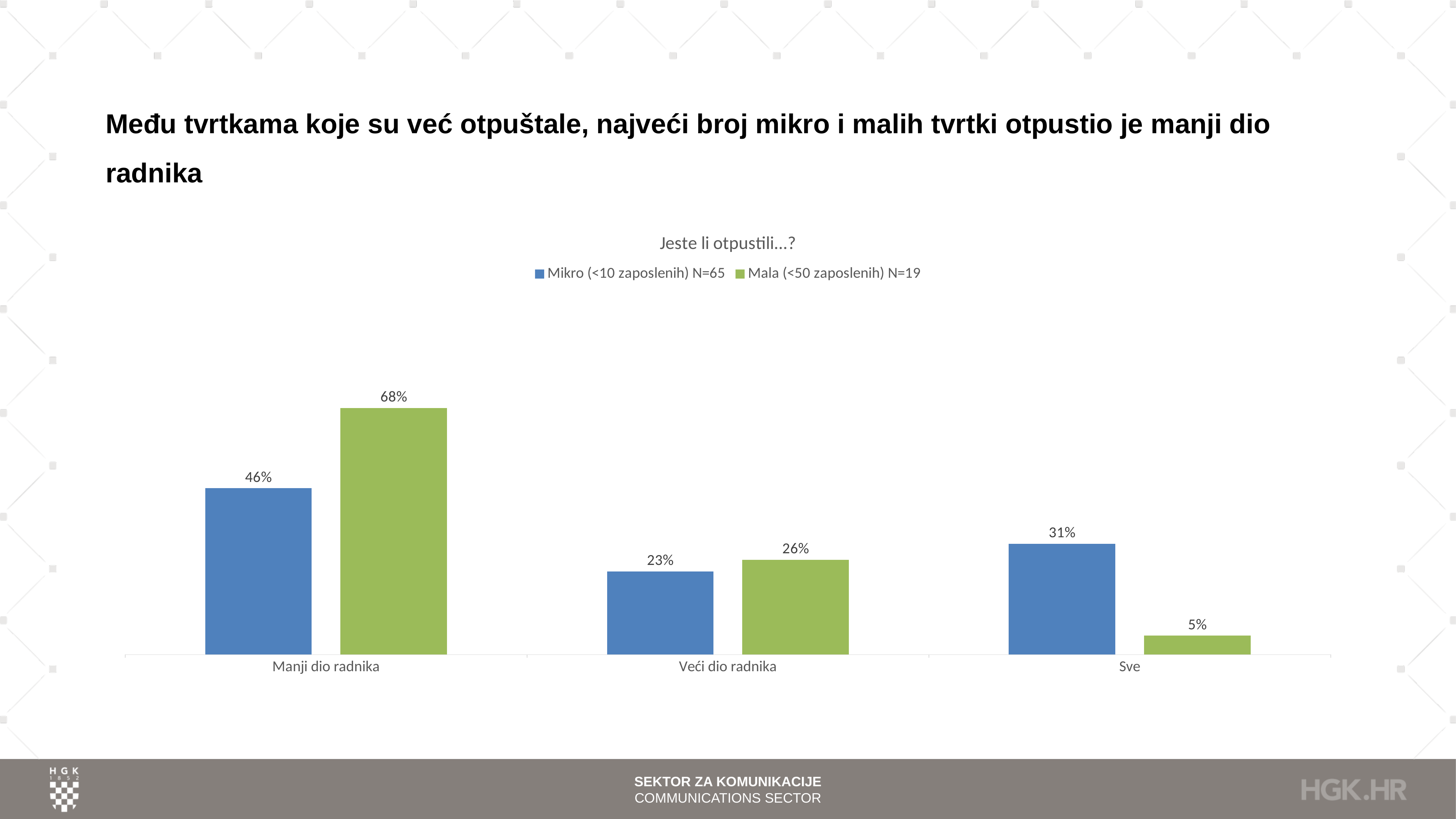
How many series does the legend list? 2 What is the difference between the Mikro and Mala values in the Sve category? 26% What is the value for Mala (<50 zaposlenih) N=19 in the Veći dio radnika category? 26% What is the difference between the Mala and Mikro values in the Manji dio radnika category? 22% What is the value for Mala (<50 zaposlenih) N=19 in the Sve category? 5% How many categories are shown on the x axis? 3 What is the title of the chart? Jeste li otpustili…? Which category has the highest value for the Mala (<50 zaposlenih) N=19 series? Manji dio radnika Which category has the lowest value for the Mikro (<10 zaposlenih) N=65 series? Veći dio radnika What kind of chart is shown on the slide? Bar chart What is the value for Mikro (<10 zaposlenih) N=65 in the Manji dio radnika category? 46% In the Sve category, which series has the larger value, Mikro (<10 zaposlenih) N=65 or Mala (<50 zaposlenih) N=19? Mikro (<10 zaposlenih) N=65